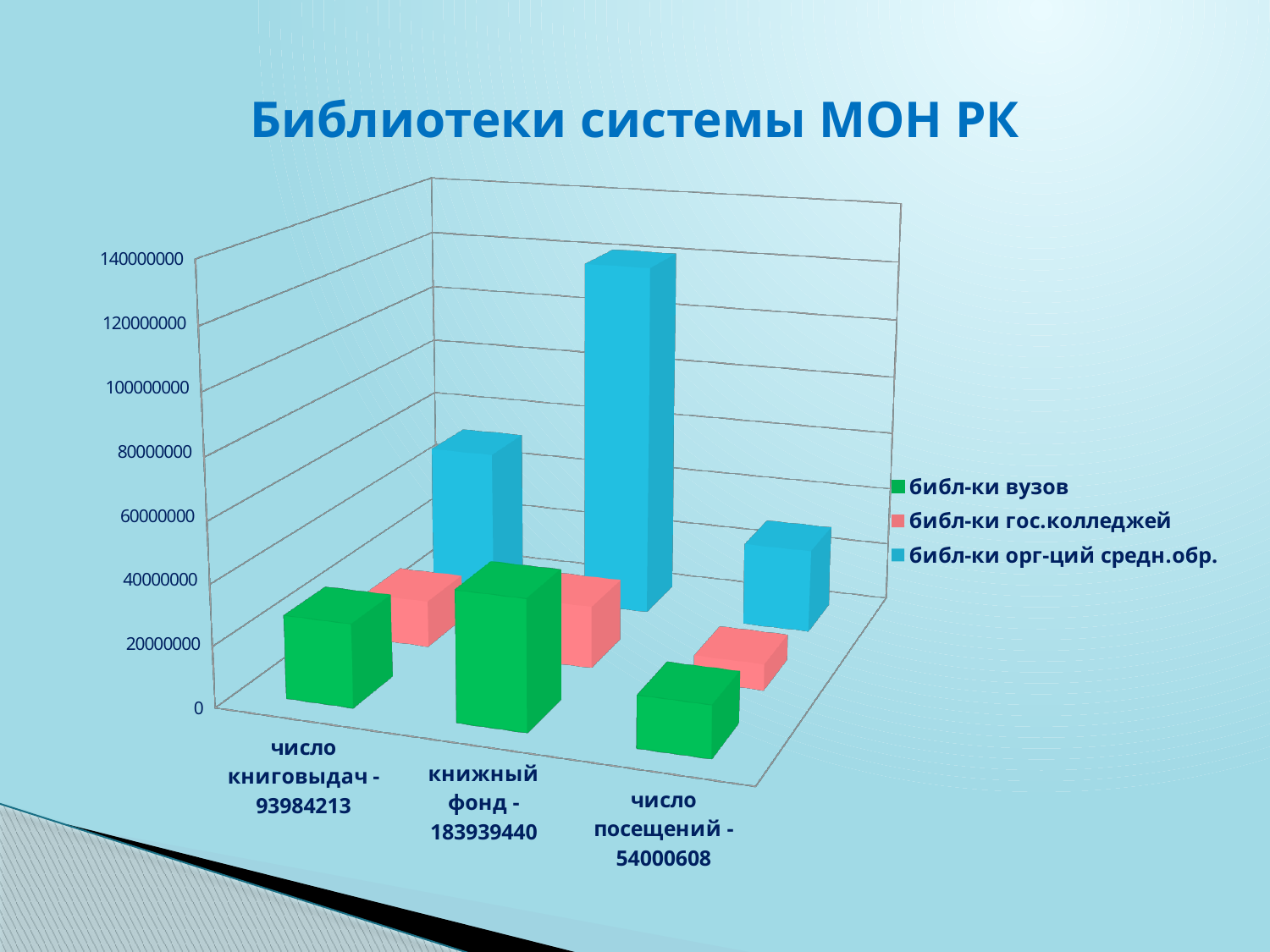
How many categories are shown on the x axis of the chart? 3 What kind of chart is shown on the slide? bar chart How many series does the chart legend list? 3 Is the value for библ-ки орг-ций средн.обр. in the книжный фонд category greater or less than 100000000? greater What is the title of the chart on the slide? Библиотеки системы МОН РК For which category is the value for библ-ки орг-ций средн.обр. the lowest? число посещений Is the value for библ-ки гос.колледжей in the книжный фонд category greater or less than 40000000? less For библ-ки вузов, which category has the larger value: книжный фонд or число посещений? книжный фонд Which series is shown in green in the chart? библ-ки вузов In the книжный фонд category, which series has the larger value: библ-ки вузов or библ-ки орг-ций средн.обр.? библ-ки орг-ций средн.обр. For which category is the value for библ-ки орг-ций средн.обр. the highest? книжный фонд Is the value for библ-ки орг-ций средн.обр. in the число книговыдач category greater or less than 40000000? greater